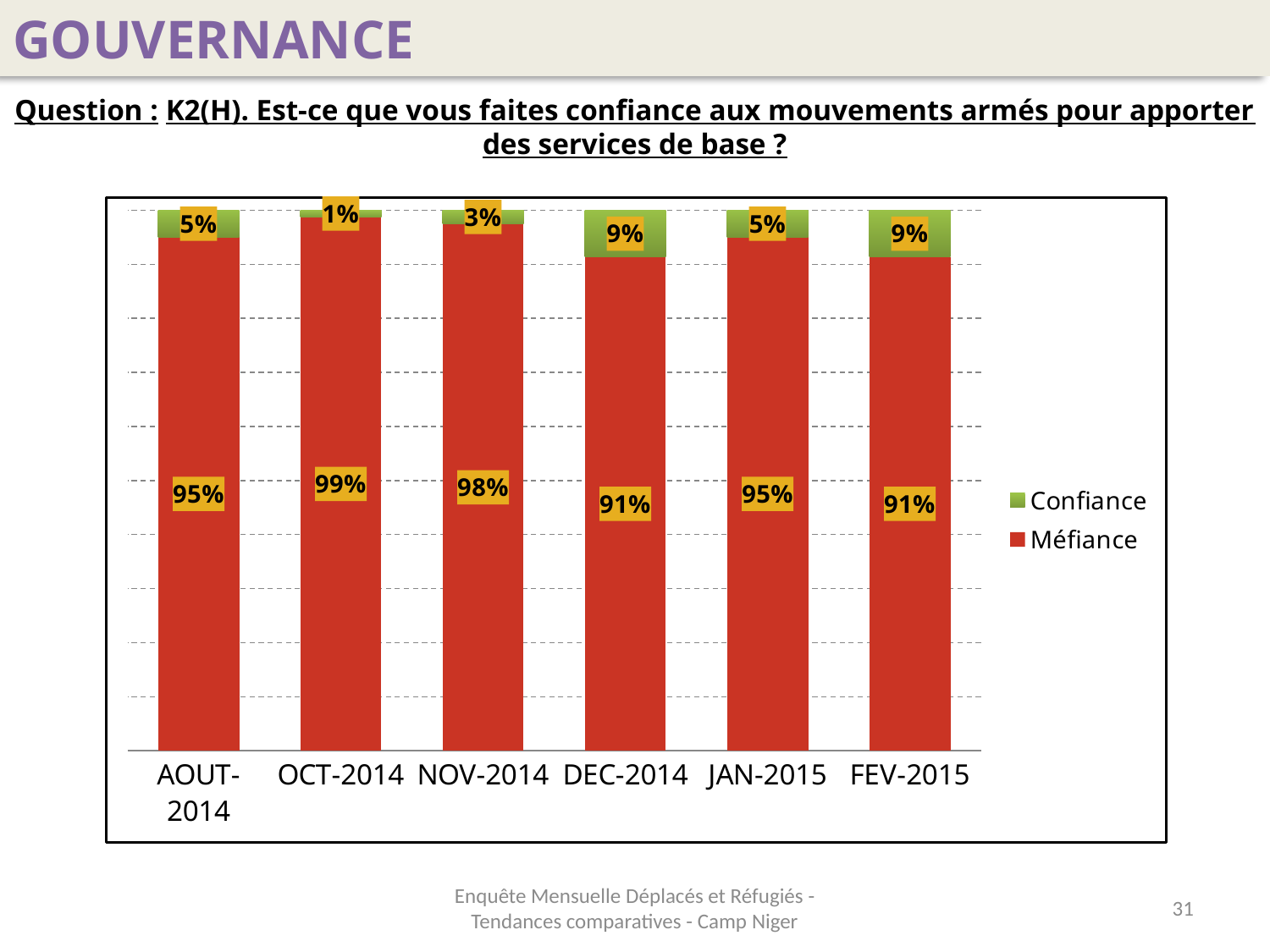
What is the total of the stacked bar for JAN-2015? 100% What is the Méfiance value for FEV-2015? 91% What is the Confiance value for DEC-2014? 9% What is the Méfiance value for OCT-2014? 99% What is the Confiance value for AOUT-2014? 5% Which month has the highest Méfiance value? OCT-2014 How many months are shown on the x axis? 6 Which month has the lowest Confiance value? OCT-2014 How many series does the legend list? 2 What kind of chart is shown on the slide? Stacked bar chart What is the difference between the Méfiance values for NOV-2014 and DEC-2014? 7% Which is larger, the Confiance value for NOV-2014 or for JAN-2015? JAN-2015